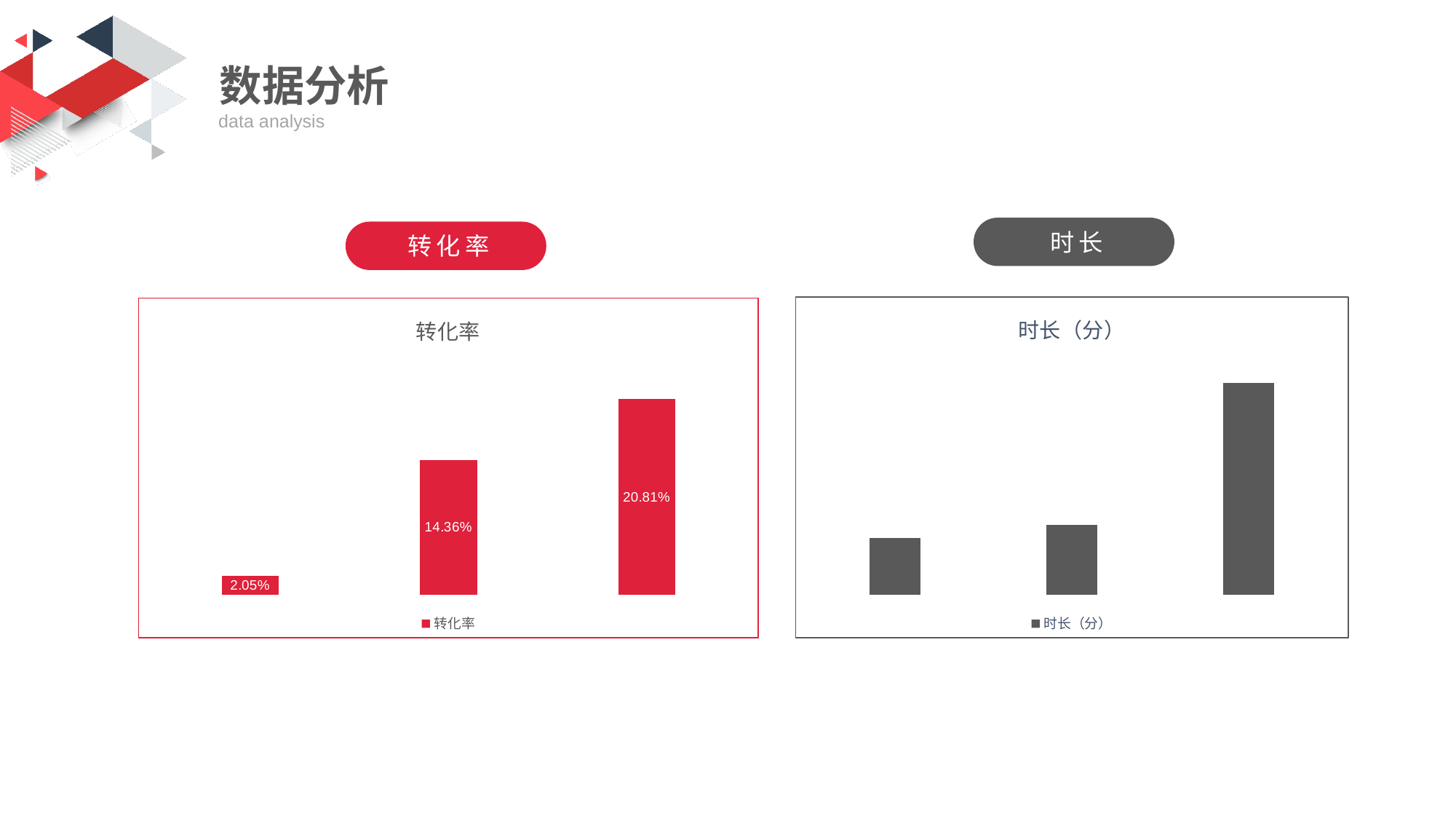
In the 时长（分） chart on the right, which bar is the shortest? The first (leftmost) bar In the 转化率 chart on the left, what is the value of the middle bar? 14.36% In the 转化率 chart on the left, what is the value of the first (leftmost) bar? 2.05% In the 转化率 chart on the left, do the values rise or fall from left to right? Rise In the 转化率 chart on the left, which bar has the highest value? The third (rightmost) bar, 20.81% What type of chart is the 时长（分） chart on the right? Bar chart What series name does the legend of the chart on the right show? 时长（分） In the 转化率 chart on the left, which bar has the lowest value? The first (leftmost) bar, 2.05% In the 转化率 chart on the left, what is the difference between the third bar and the first bar? 18.76% In the 时长（分） chart on the right, which bar is the tallest? The third (rightmost) bar In the 转化率 chart on the left, what is the value of the third (rightmost) bar? 20.81% How many bars are plotted in the 转化率 chart on the left? 3